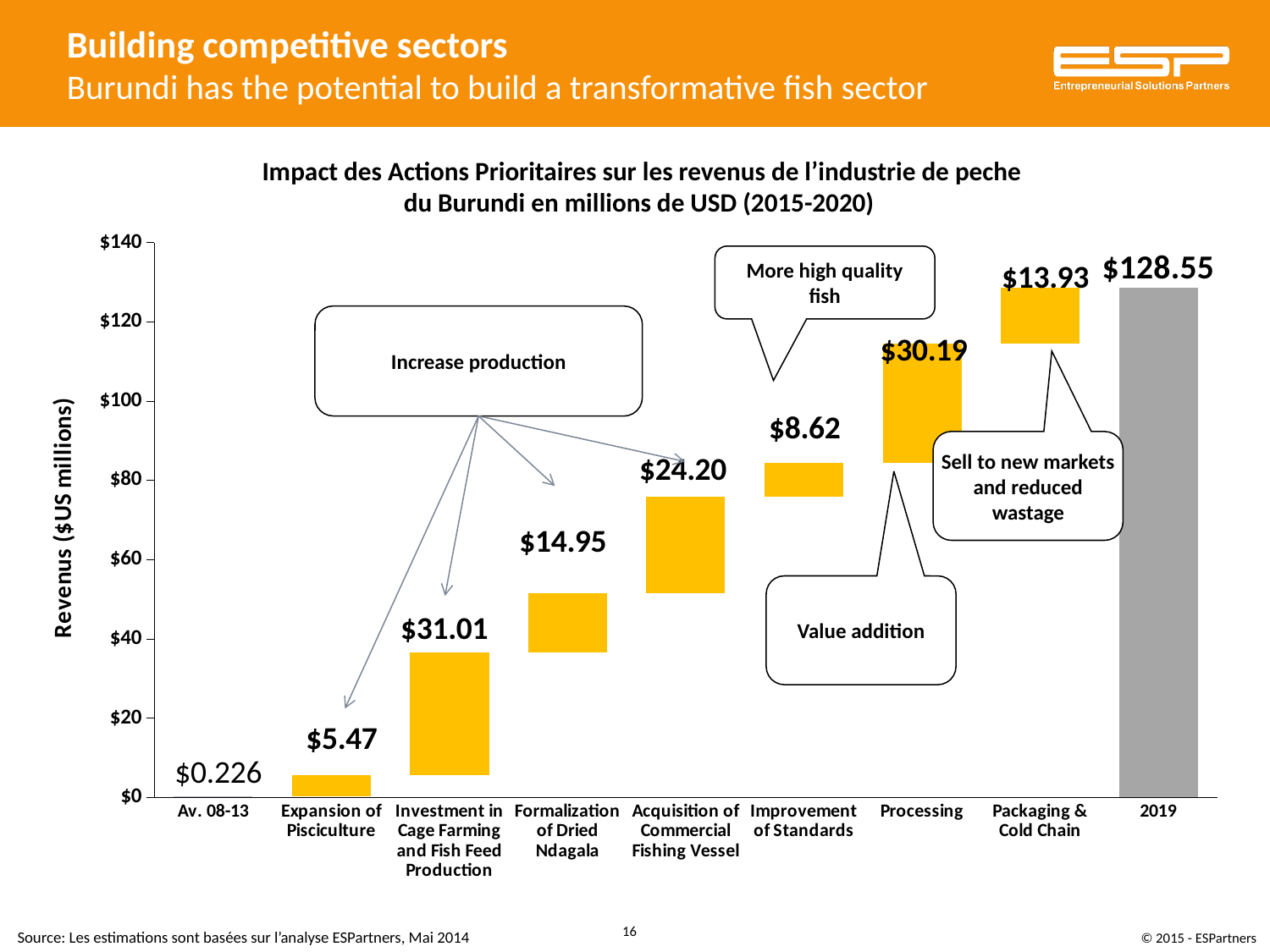
What is the difference between the values for Processing and Improvement of Standards? $21.57 Which category has the lowest value on the chart? Av. 08-13 What is the value shown for Expansion of Pisciculture? $5.47 How many categories are shown on the x axis? 9 What is the value shown for Av. 08-13? $0.226 What is the value shown for the 2019 bar? $128.55 What kind of chart is shown on the slide? Bar chart What is the value shown for Investment in Cage Farming and Fish Feed Production? $31.01 Which category has the highest value on the chart? 2019 What is the label of the y axis? Revenus ($US millions) Which is larger, the value for Acquisition of Commercial Fishing Vessel or the value for Packaging & Cold Chain? Acquisition of Commercial Fishing Vessel What is the value shown for Processing? $30.19